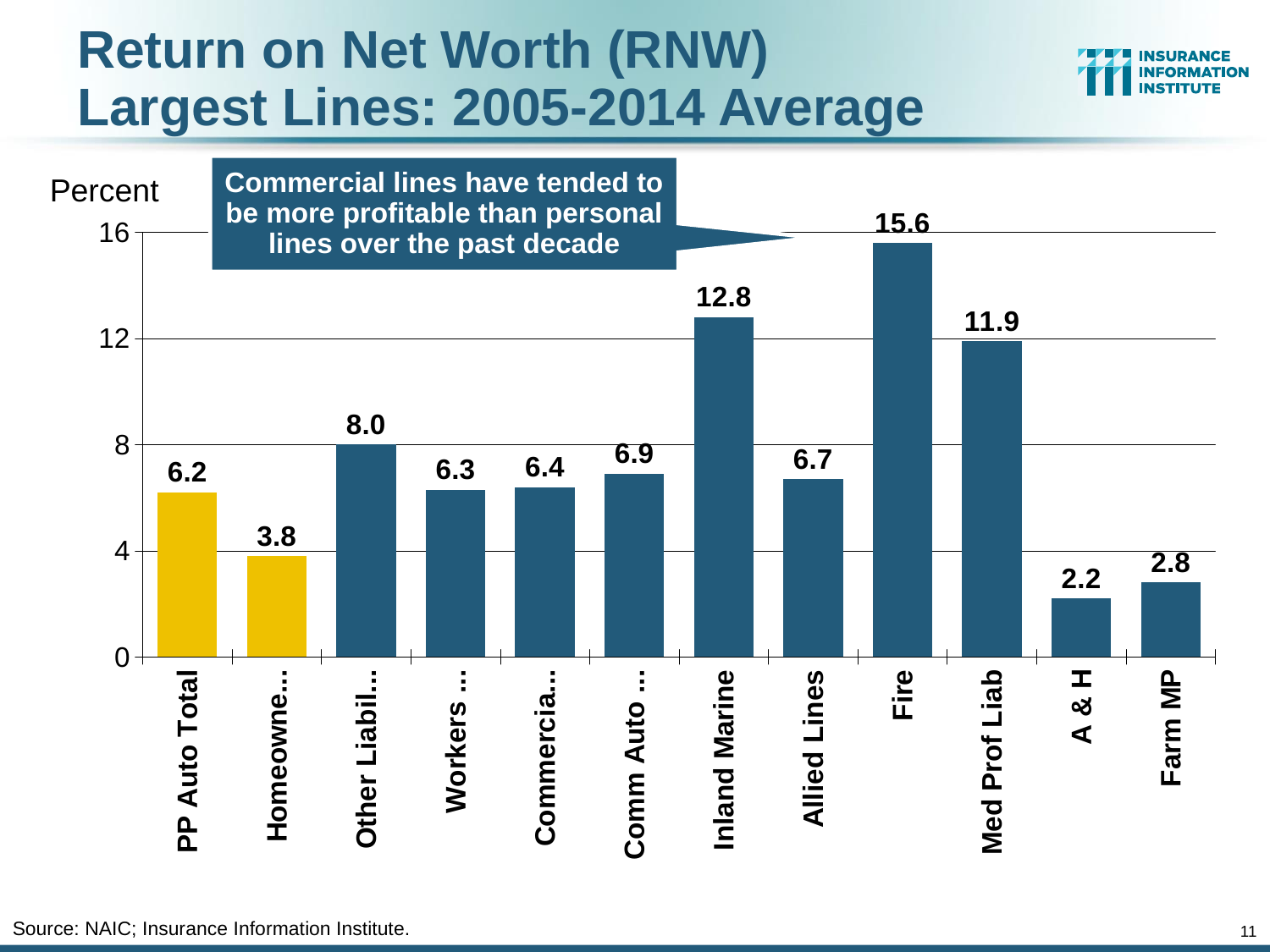
How many categories are shown on the chart? 12 What is the value for PP Auto Total? 6.2 What colour are the bars for PP Auto Total and the second category, compared with the rest? Yellow; the rest are dark blue What is the value for Farm MP? 2.8 Is the value for Inland Marine greater or less than 12? greater Which is larger, the value for Allied Lines or the value for Med Prof Liab? Med Prof Liab What is the difference between the values for Fire and Inland Marine? 2.8 What is the value for Med Prof Liab? 11.9 What kind of chart is shown on the slide? Bar chart What is the value for Fire? 15.6 Which category has the lowest value? A & H Which category has the highest value? Fire